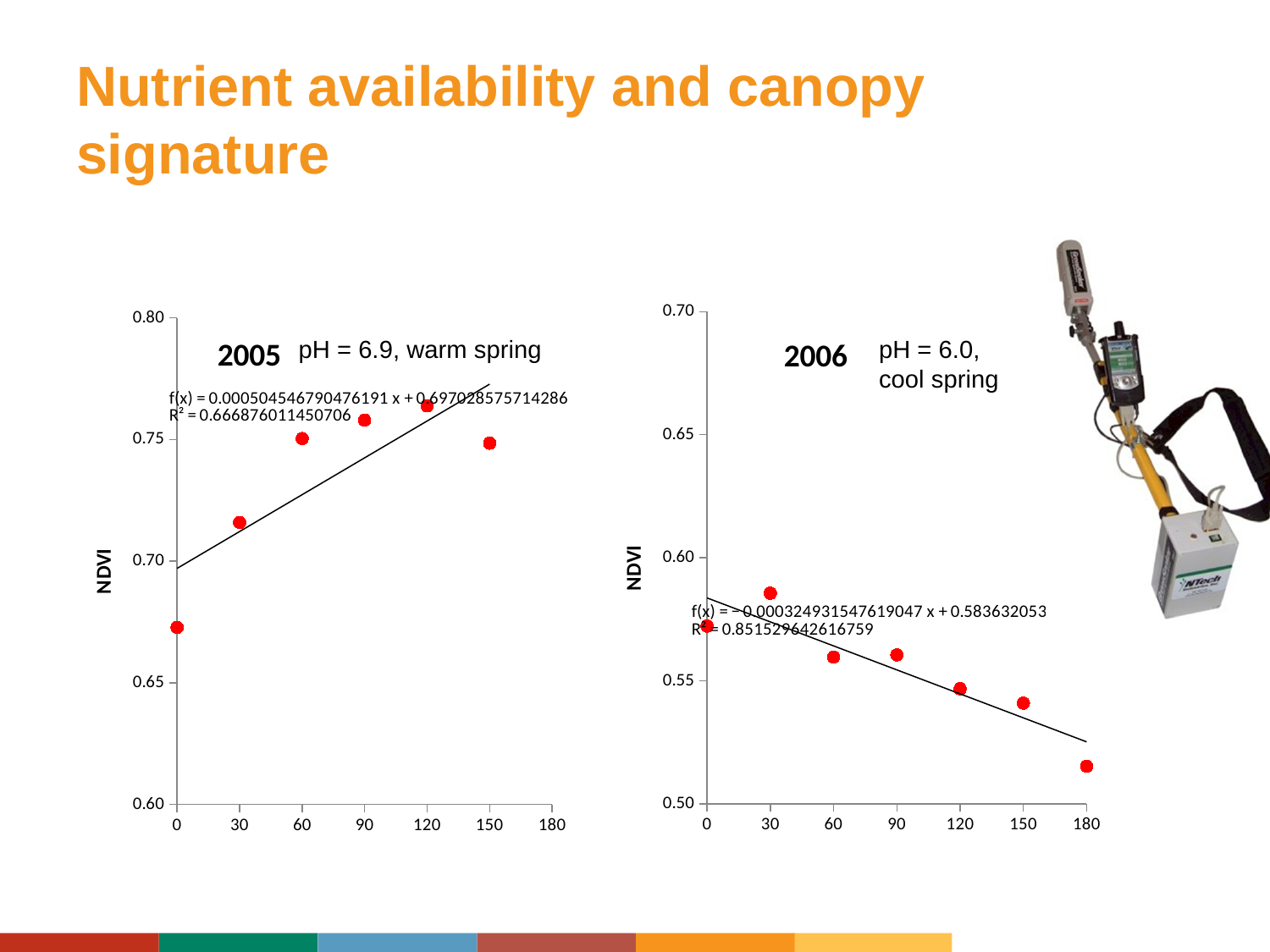
How many data points are plotted in the 2005 chart? 6 In the 2006 chart, is the NDVI value at x = 180 greater or less than 0.55? less In the 2006 chart, do the NDVI values generally rise or fall as the x value increases? fall In the 2005 chart, is the NDVI value at x = 0 greater or less than 0.70? less In the 2006 chart, at which x value is the NDVI lowest? 180 In the 2005 chart, do the NDVI values generally rise or fall as the x value increases? rise What kind of chart is the 2005 chart on the left? scatter chart In the 2006 chart, at which x value is the NDVI highest? 30 In the 2005 chart, which has the higher NDVI: the point at x = 30 or the point at x = 60? x = 60 What R² value is shown for the trend line in the 2006 chart? 0.851529642616759 In the 2005 chart, at which x value is the NDVI lowest? 0 How many data points are plotted in the 2006 chart? 7